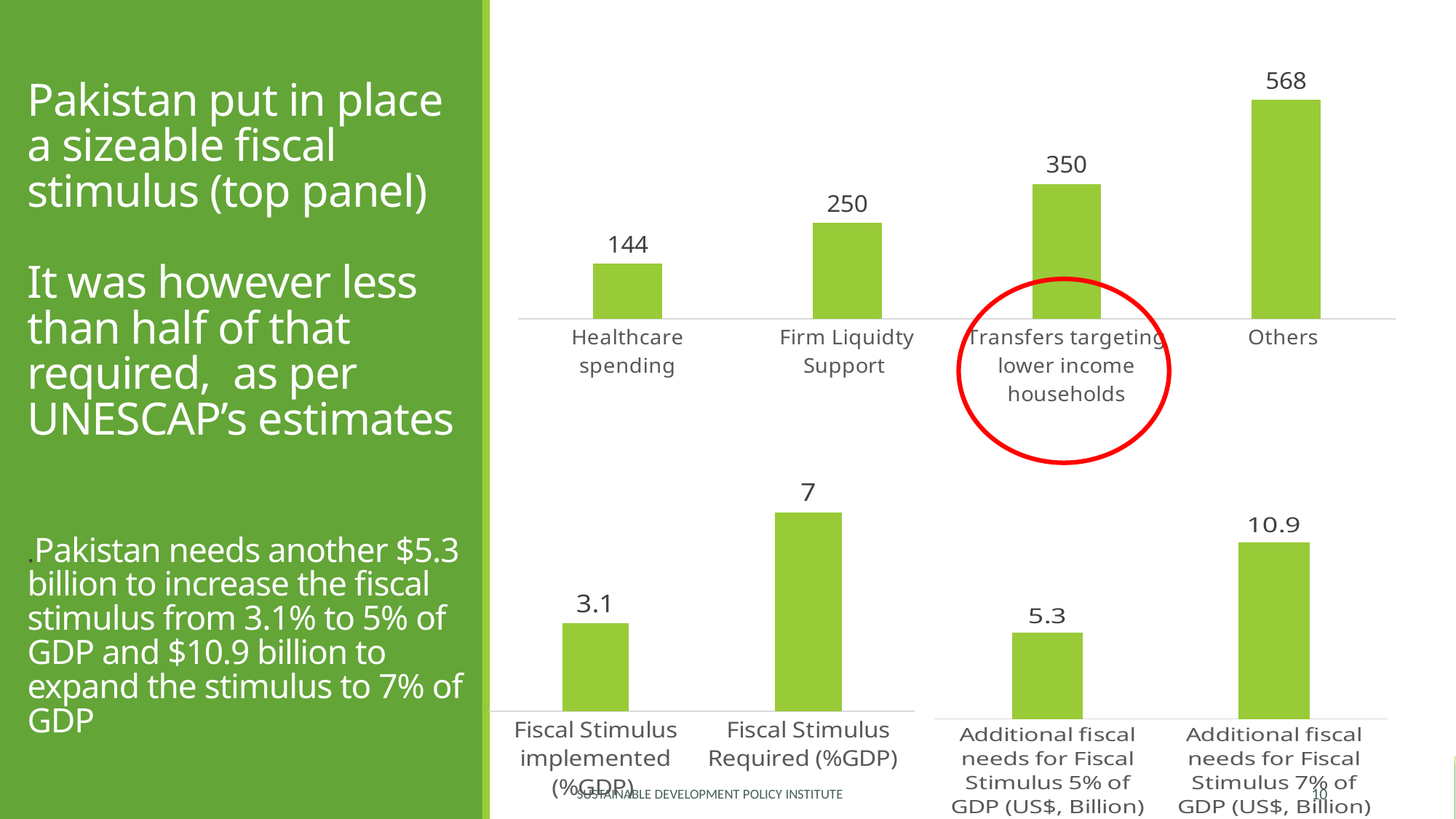
In the bottom-left chart, what is the difference between Fiscal Stimulus Required (%GDP) and Fiscal Stimulus implemented (%GDP)? 3.9 In the bottom-right chart, what is the value for Additional fiscal needs for Fiscal Stimulus 7% of GDP (US$, Billion)? 10.9 In the top chart, what is the value for Healthcare spending? 144 In the top chart, what is the value for Transfers targeting lower income households? 350 In the top chart, what is the difference between Others and Firm Liquidty Support? 318 In the bottom-left chart, what is the value for Fiscal Stimulus Required (%GDP)? 7 In the bottom-right chart, which is larger: the additional fiscal needs for a 5% of GDP stimulus or for a 7% of GDP stimulus? 7% of GDP In the top chart, which category has the highest value? Others What type of chart is the top chart? Bar chart In the top chart, how many categories are shown? 4 In the top chart, which category has the lowest value? Healthcare spending In the top chart, which category is circled in red? Transfers targeting lower income households